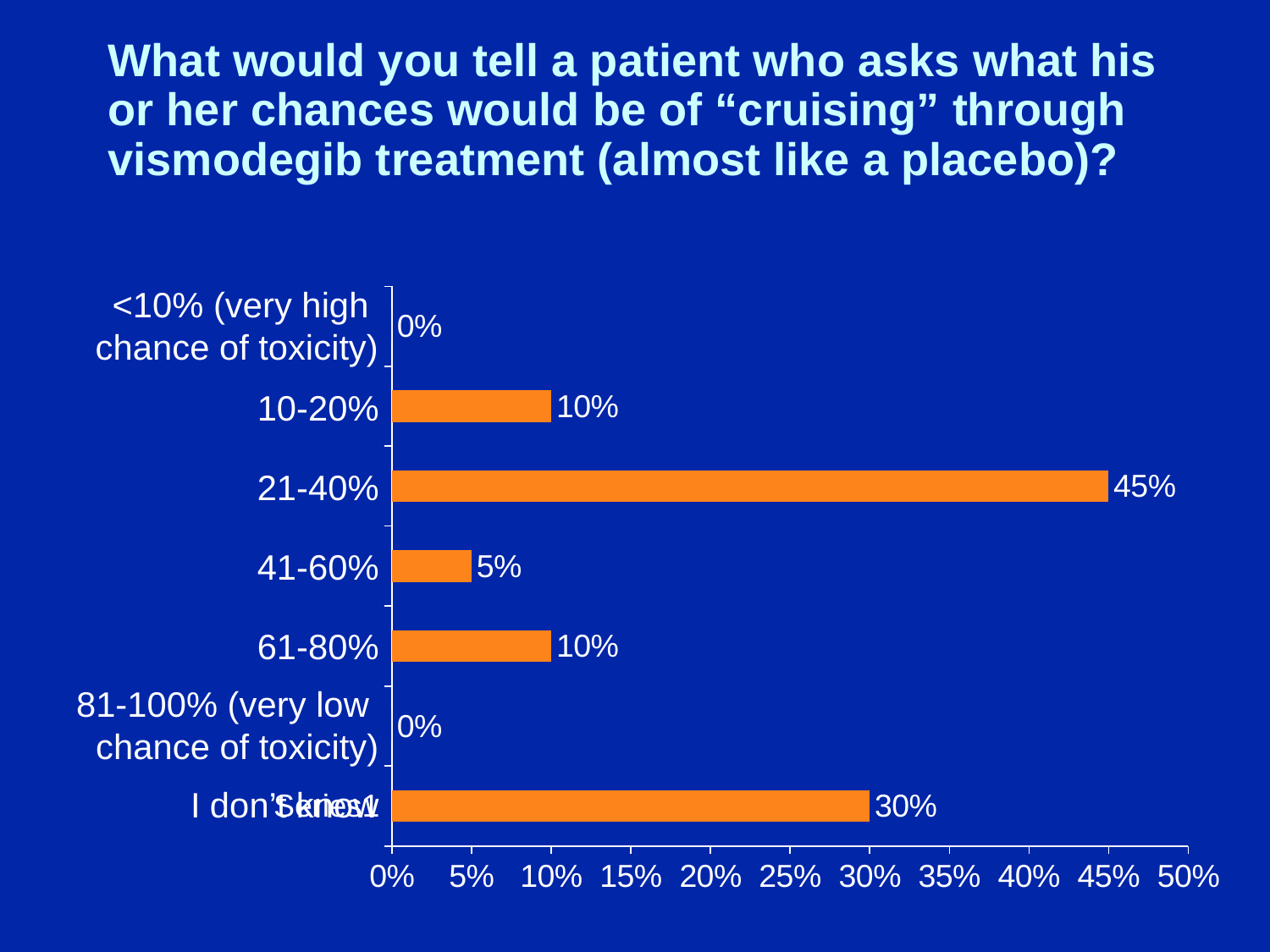
What is the value for the 41-60% category? 5% What value is shown for the '<10% (very high chance of toxicity)' category? 0% What is the highest value shown on the x axis? 50% What kind of chart is shown on the slide? bar chart Which category has the highest value? 21-40% What is the value for the 10-20% category? 10% Which is larger, the value for 10-20% or the value for 41-60%? 10-20% What is the value for the bottom category of the chart? 30% What percentage of respondents chose 21-40%? 45% What is the value for the 61-80% category? 10% How many categories are shown on the chart? 7 What is the difference between the values for 21-40% and 41-60%? 40%